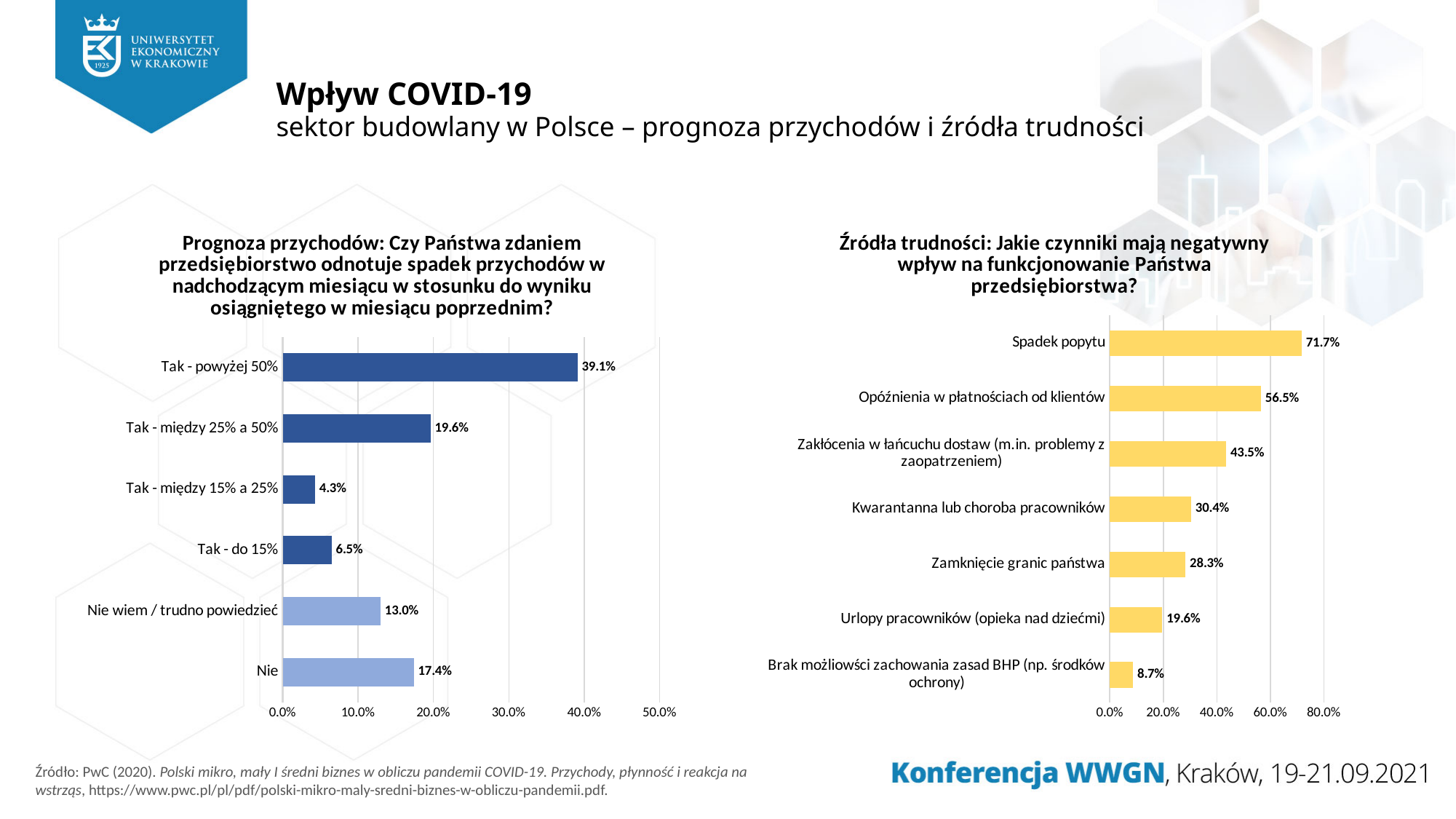
In the left chart (Prognoza przychodów), which category has the lowest value? Tak - między 15% a 25% In the right chart (Źródła trudności), which factor has the highest value? Spadek popytu In the left chart (Prognoza przychodów), what is the value for 'Tak - powyżej 50%'? 39.1% In the right chart (Źródła trudności), what is the value for 'Spadek popytu'? 71.7% In the right chart (Źródła trudności), how many factors are listed? 7 In the left chart (Prognoza przychodów), what is the value for 'Nie'? 17.4% What type of chart is the right chart (Źródła trudności)? Bar chart In the left chart (Prognoza przychodów), what is the difference between 'Tak - powyżej 50%' and 'Tak - między 25% a 50%'? 19.5% In the right chart (Źródła trudności), what is the difference between 'Opóźnienia w płatnościach od klientów' and 'Zakłócenia w łańcuchu dostaw (m.in. problemy z zaopatrzeniem)'? 13.0% In the right chart (Źródła trudności), what is the value for 'Zamknięcie granic państwa'? 28.3% In the left chart (Prognoza przychodów), which is larger: 'Nie wiem / trudno powiedzieć' or 'Nie'? Nie In the left chart (Prognoza przychodów), how many categories are shown? 6